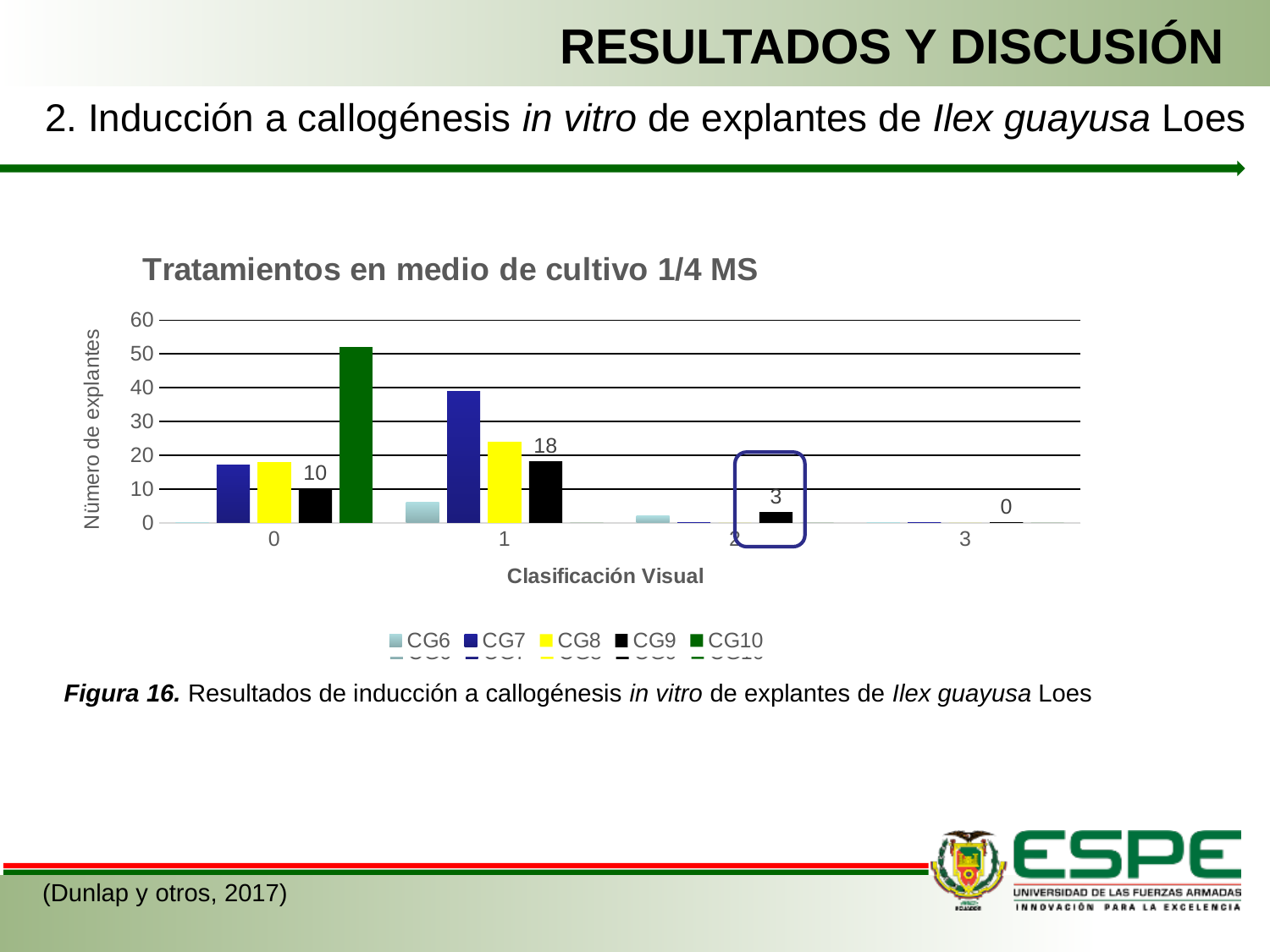
At which Clasificación Visual category does CG9 reach its highest value? 1 How many series does the legend list? 5 What is the value for CG9 at Clasificación Visual 1? 18 What is the value for CG9 at Clasificación Visual 2? 3 Is the value for CG7 at Clasificación Visual 1 greater or less than 30? greater What is the title of the vertical axis of the chart? Número de explantes Is the value for CG10 at Clasificación Visual 0 greater or less than 40? greater What is the difference between the CG9 values at Clasificación Visual 1 and Clasificación Visual 0? 8 What is the value for CG9 at Clasificación Visual 0? 10 What is the value for CG9 at Clasificación Visual 3? 0 What kind of chart is shown on the slide? Bar chart Which is larger: CG10 at Clasificación Visual 0 or CG7 at Clasificación Visual 1? CG10 at Clasificación Visual 0